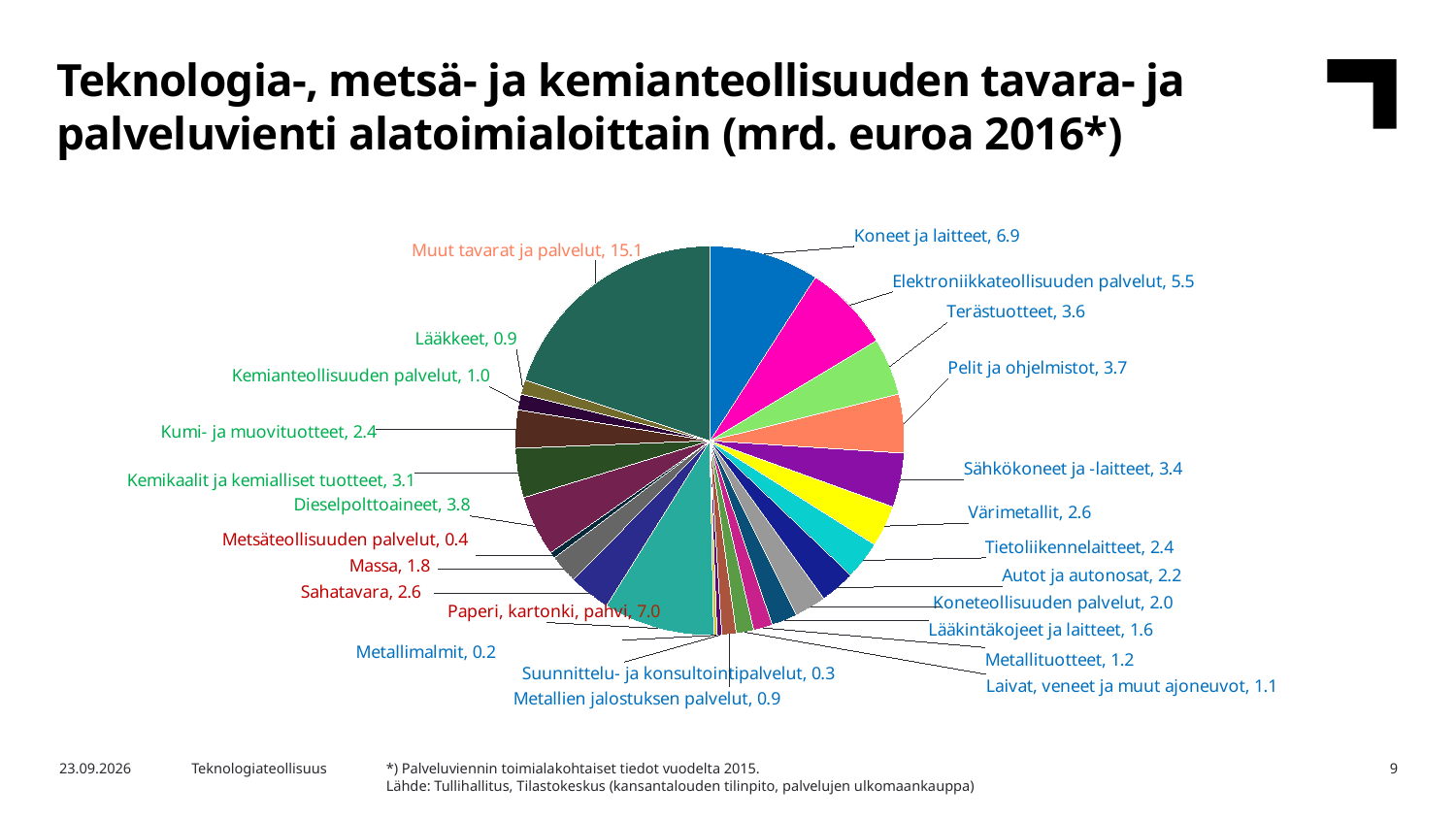
Which category has the smallest slice of the pie? Metallimalmit What is the value for Koneet ja laitteet? 6.9 Which category has the largest slice of the pie? Muut tavarat ja palvelut What is the value for Dieselpolttoaineet? 3.8 What is the difference between Koneet ja laitteet and Elektroniikkateollisuuden palvelut? 1.4 What unit is given in the chart title for the values? mrd. euroa How many slices does the pie chart have? 25 What is the difference between Dieselpolttoaineet and Kemikaalit ja kemialliset tuotteet? 0.7 What is the value for Paperi, kartonki, pahvi? 7.0 What is the value for Laivat, veneet ja muut ajoneuvot? 1.1 What kind of chart is shown on the slide? pie chart Which is larger, Koneet ja laitteet or Elektroniikkateollisuuden palvelut? Koneet ja laitteet